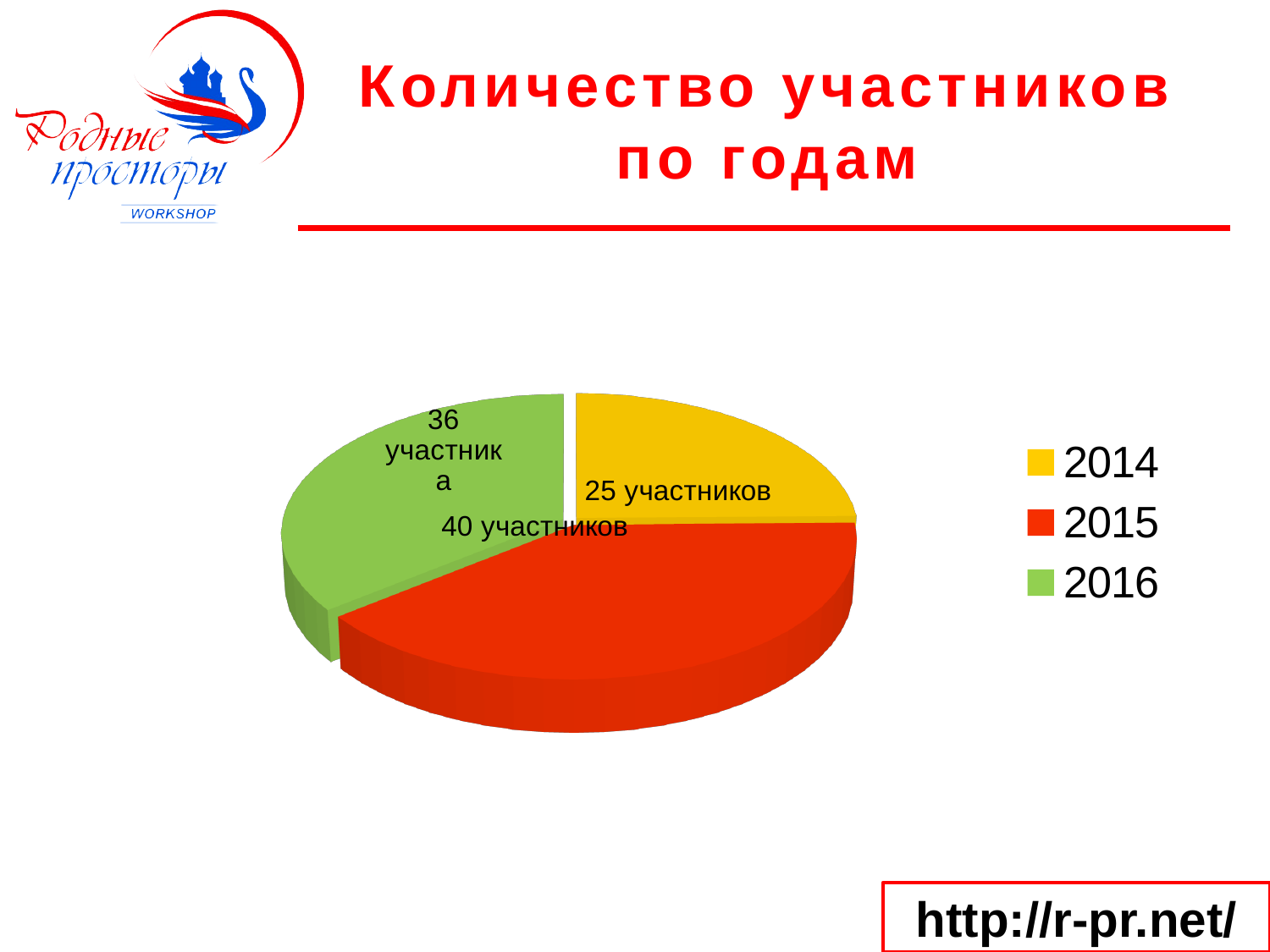
What colour is the slice for 2016? Green What is the difference between the number of participants in 2015 and in 2014? 15 How many entries does the legend list? 3 What is the value shown for 2016? 36 участника What is the value shown for 2014? 25 участников Which year has the largest number of participants? 2015 What is the title of the chart on the slide? Количество участников по годам Which year had more participants, 2016 or 2014? 2016 How many slices does the pie chart have? 3 What is the value shown for 2015? 40 участников What kind of chart is shown on the slide? Pie chart Which year has the smallest number of participants? 2014